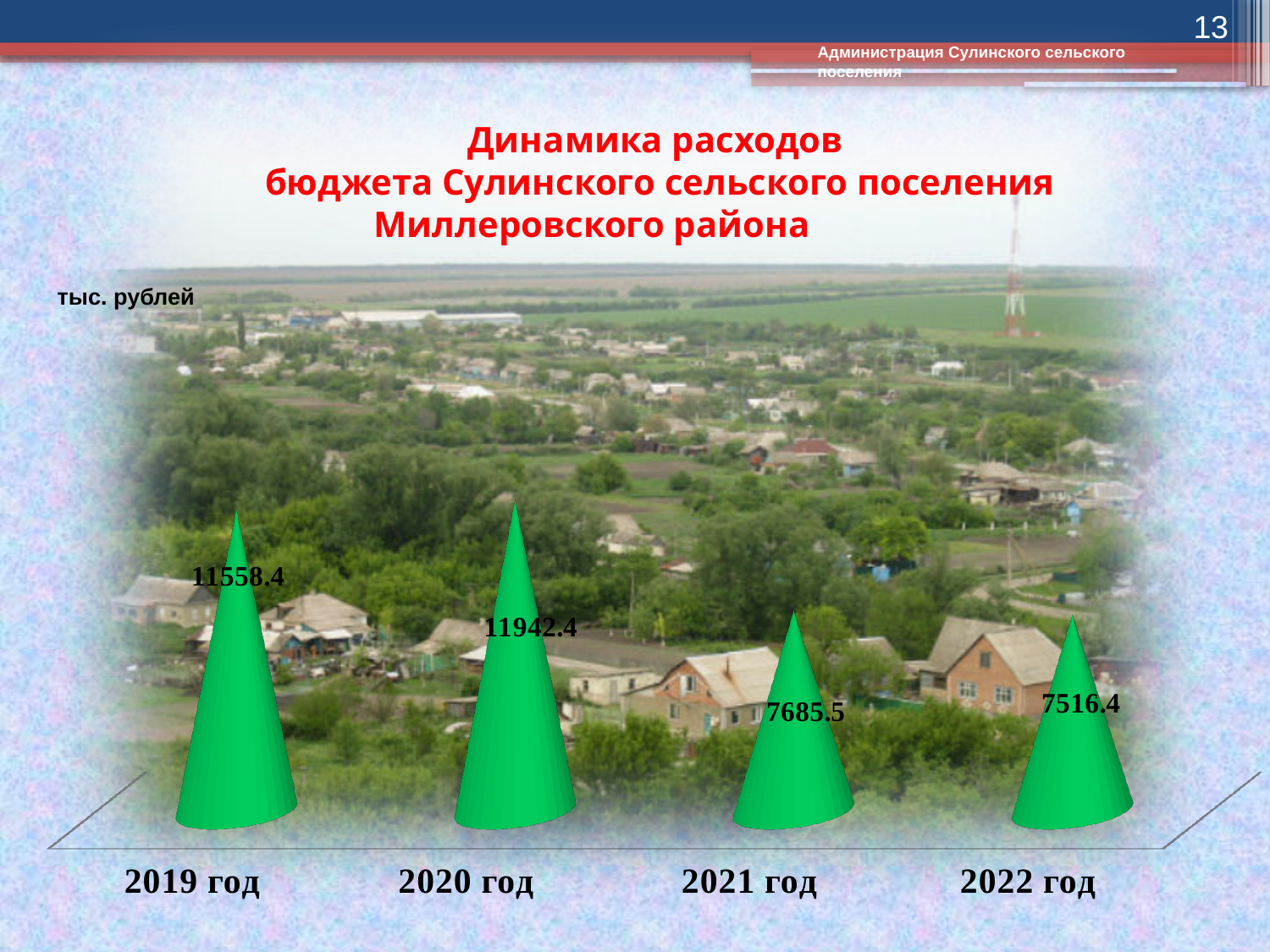
Which is larger, the value for 2019 год or the value for 2021 год? 2019 год How many years are shown on the chart? 4 What is the difference between the values for 2020 год and 2019 год? 384.0 What unit is stated for the values on the chart? тыс. рублей Do the values rise or fall from 2020 год to 2022 год? fall What is the value for 2020 год? 11942.4 What is the difference between the values for 2021 год and 2022 год? 169.1 Which year has the highest value? 2020 год What is the value for 2021 год? 7685.5 Which year has the lowest value? 2022 год What is the value for 2022 год? 7516.4 What is the value for 2019 год? 11558.4